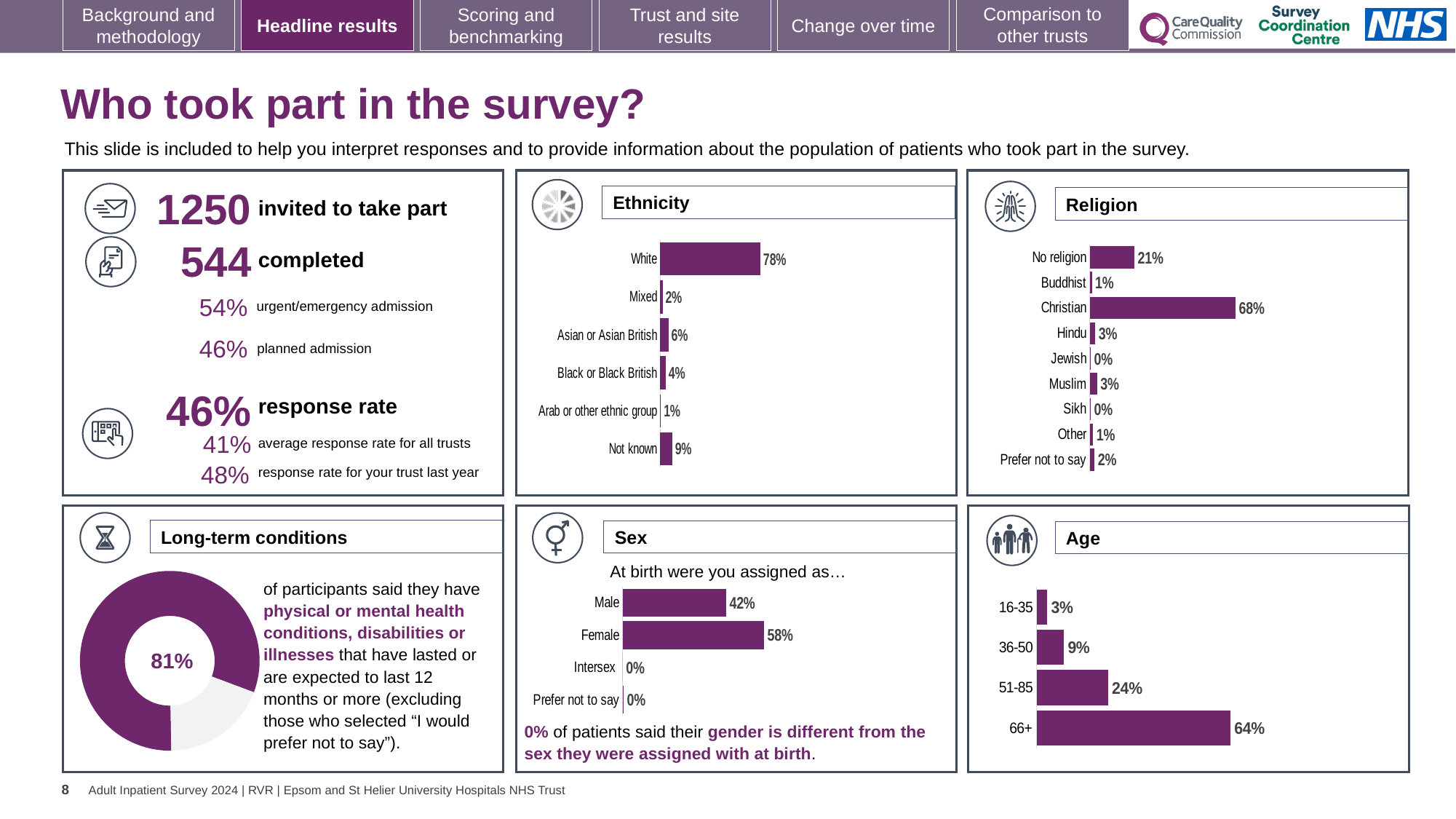
In the Ethnicity chart, how many categories are shown? 6 In the Religion chart, how many categories are shown? 9 In the Age chart, do the values rise or fall as age increases from 16-35 to 66+? rise In the Sex chart, which is larger, Male or Female? Female In the Religion chart, what percentage of respondents were Christian? 68% In the Age chart, what is the difference between the 66+ and 51-85 values? 40% In the Sex chart, what percentage of respondents were Female? 58% In the Ethnicity chart, which category has the lowest value? Arab or other ethnic group In the Ethnicity chart, what percentage of respondents were White? 78% In the Age chart, what percentage of respondents were aged 66+? 64% What kind of chart is used in the Long-term conditions panel? doughnut chart In the Religion chart, what is the difference between the Christian and No religion values? 47%